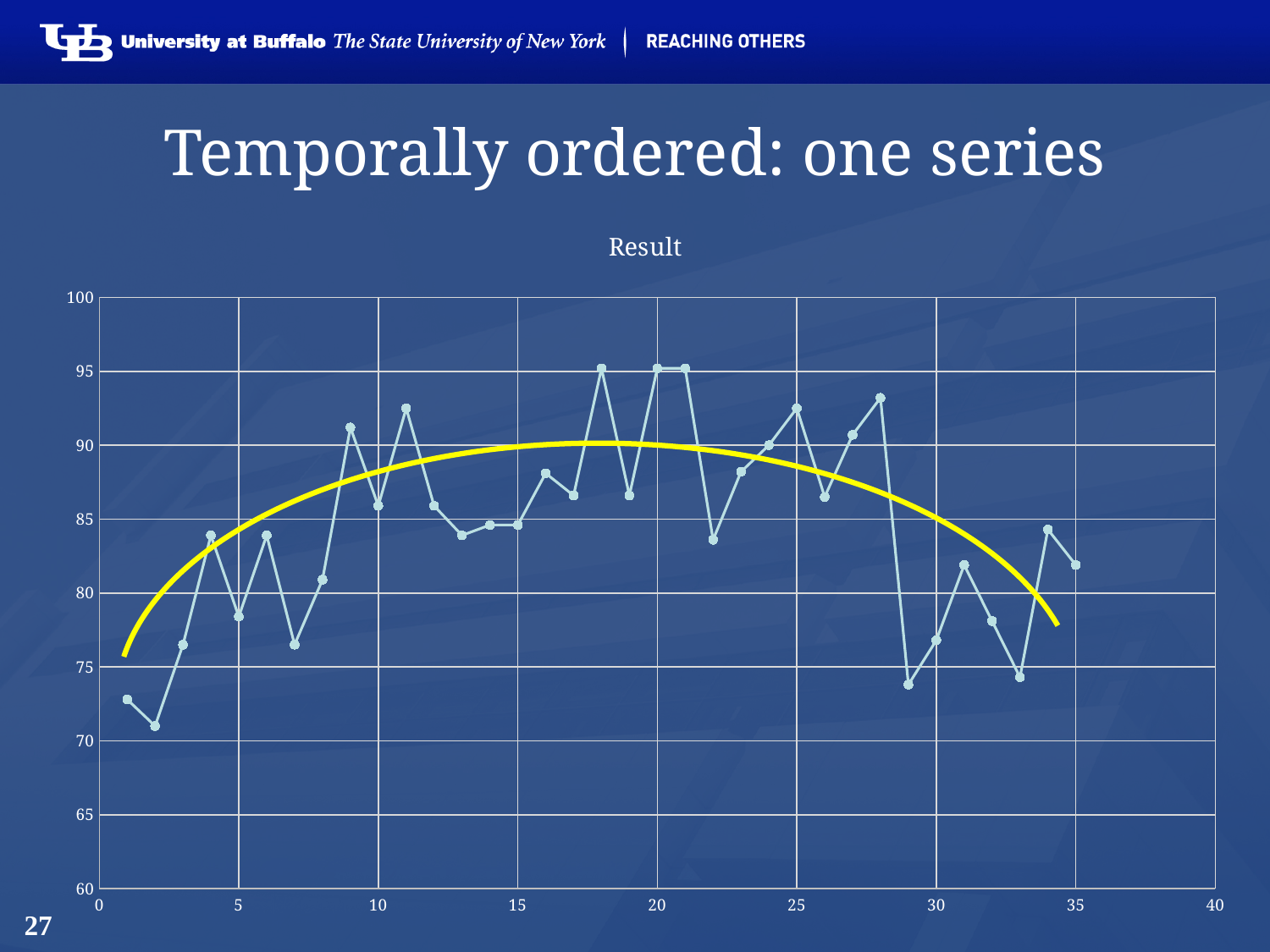
How many data points are plotted on the line? 35 Is the value at x = 29 greater or less than 80? less Which has the larger value, the point at x = 18 or the point at x = 2? x = 18 Is the value at x = 1 greater or less than 75? less Is the value at x = 2 greater or less than 75? less Which has the larger value, the point at x = 28 or the point at x = 29? x = 28 What is the title of the chart? Result Does the yellow trend curve rise or fall between x = 30 and x = 35? fall At which x value does the line reach its lowest point? 2 What kind of chart is shown on the slide? line chart